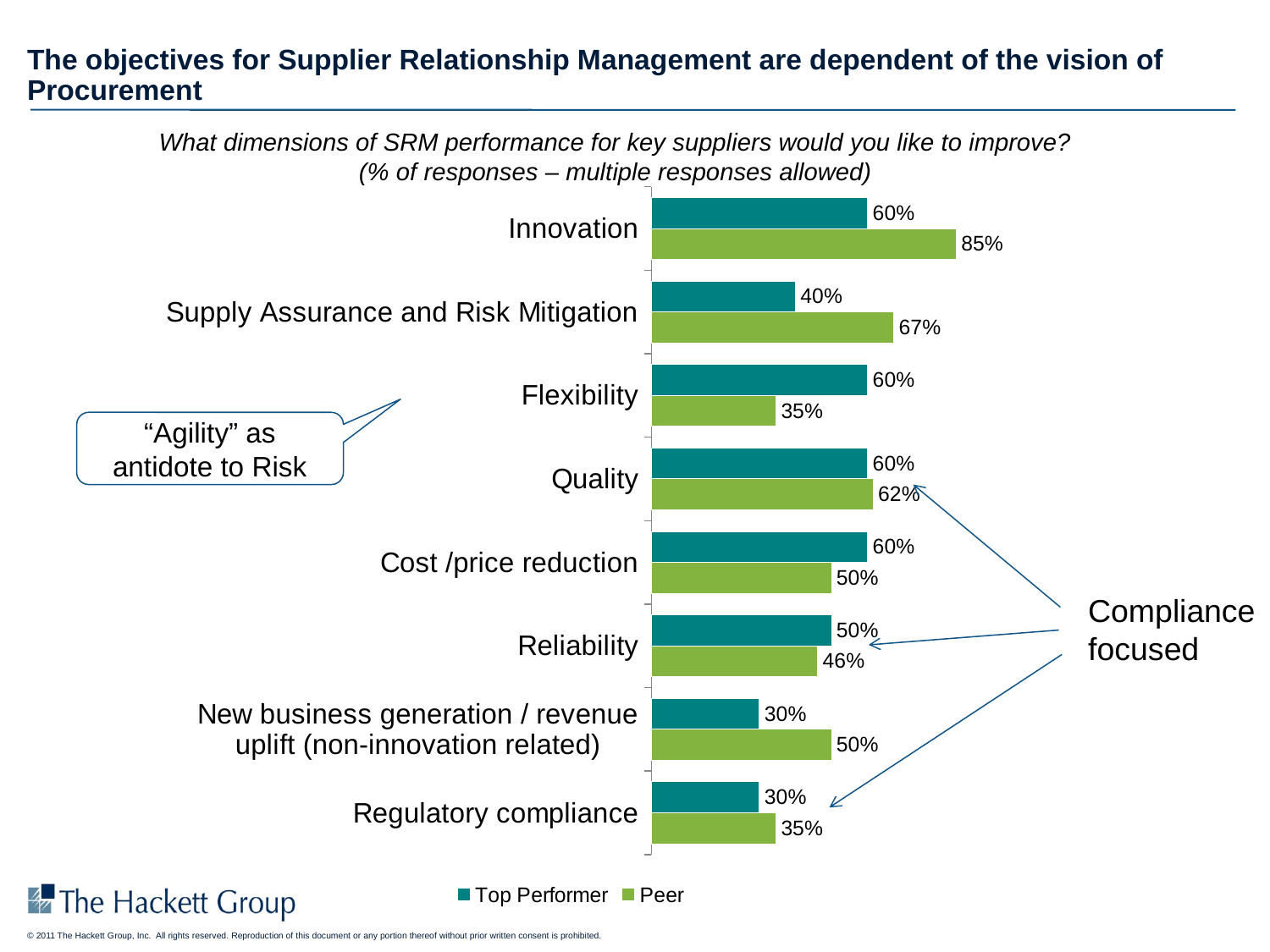
What is the Peer value for Innovation? 85% Which category has the lowest Peer value? Flexibility and Regulatory compliance (both 35%) For Flexibility, which is larger: the Top Performer value or the Peer value? Top Performer How many series does the legend list? 2 What kind of chart is shown on the slide? Bar chart What is the difference between the Peer and Top Performer values for Innovation? 25% What is the Top Performer value for Supply Assurance and Risk Mitigation? 40% Which category has the highest Peer value? Innovation For New business generation / revenue uplift (non-innovation related), which is larger: the Top Performer value or the Peer value? Peer How many categories are shown in the chart? 8 Which series is shown in light green in the legend? Peer What is the Peer value for Flexibility? 35%